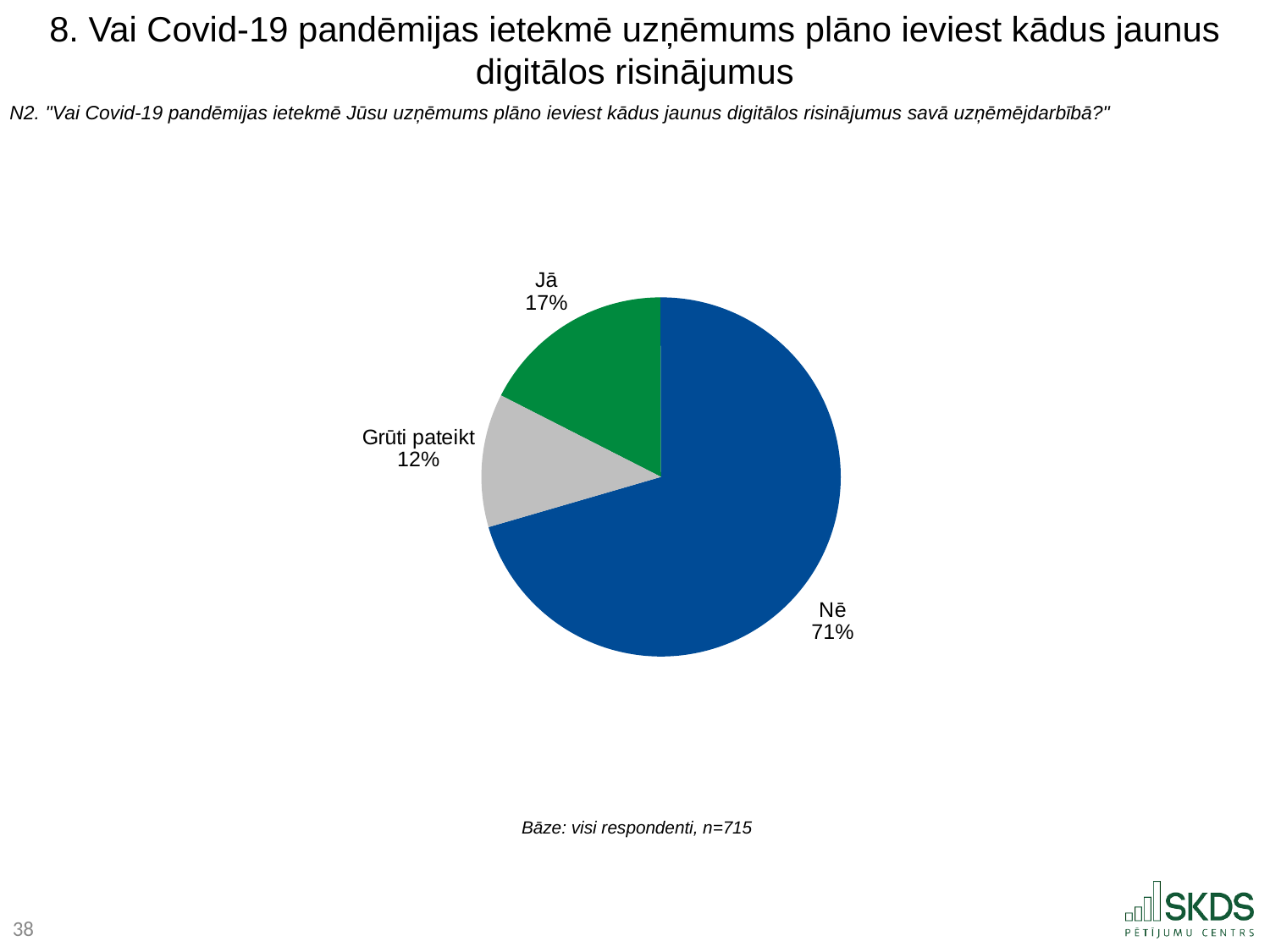
Which response has the smallest share of the pie? Grūti pateikt What colour is the "Nē" slice? Blue What is the base (number of respondents) stated below the chart? n=715 What is the difference in percentage points between "Nē" and "Jā"? 54 How many slices does the pie chart have? 3 Which response has the largest share of the pie? Nē What is the difference in percentage points between "Jā" and "Grūti pateikt"? 5 What percentage of respondents answered "Jā"? 17% What type of chart is shown on the slide? Pie chart Which is larger, the share for "Jā" or the share for "Grūti pateikt"? Jā What percentage of respondents answered "Grūti pateikt"? 12% What percentage of respondents answered "Nē"? 71%